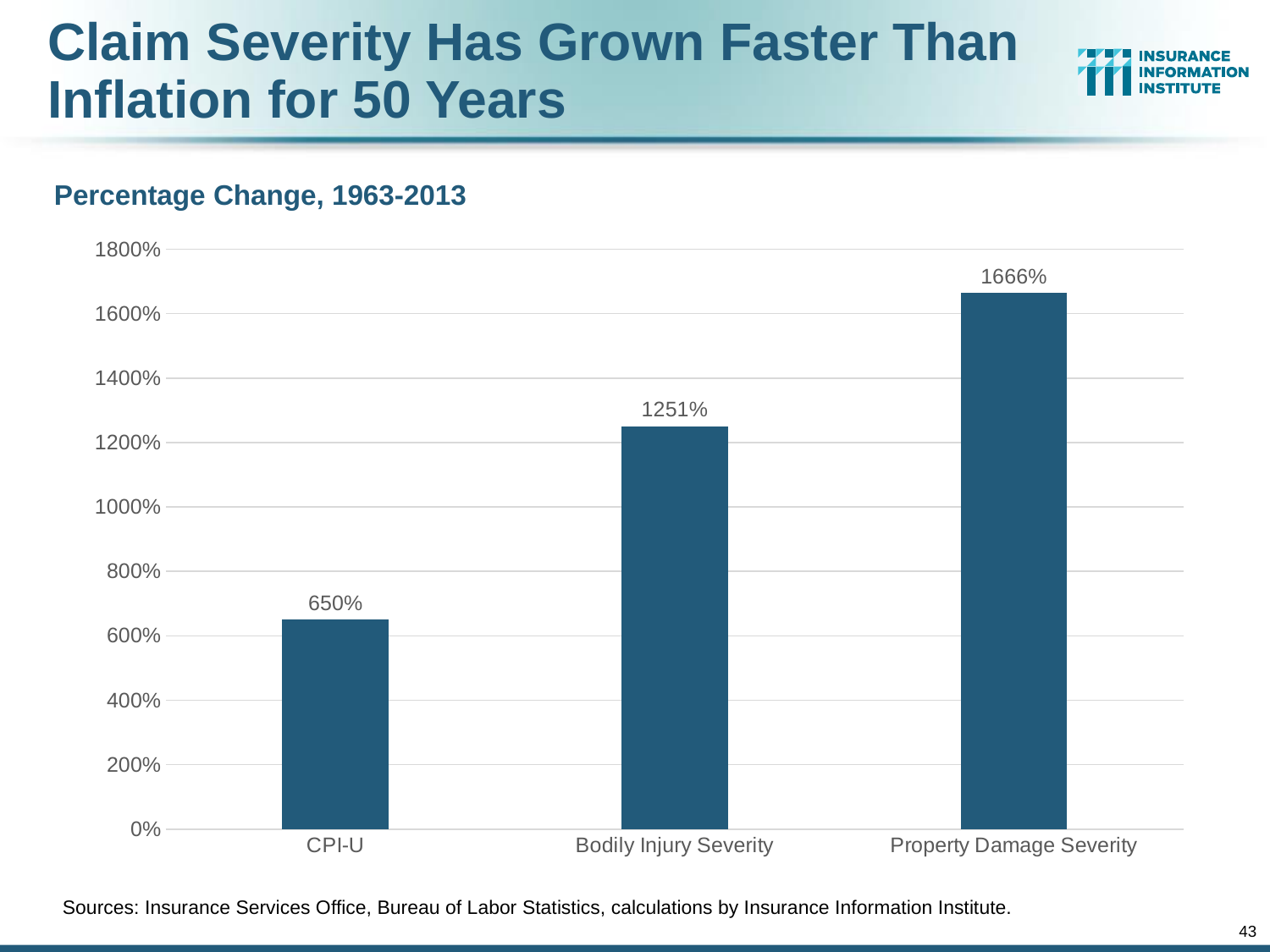
What is the percentage change for Property Damage Severity? 1666% What is the difference in percentage points between Property Damage Severity and Bodily Injury Severity? 415 What period does the chart's subtitle say the percentage change covers? 1963-2013 Is the value for Bodily Injury Severity greater or less than 1400%? less What is the percentage change for Bodily Injury Severity? 1251% What kind of chart is shown on the slide? Bar chart Which category has the highest percentage change? Property Damage Severity Which is larger, the value for Bodily Injury Severity or the value for CPI-U? Bodily Injury Severity What is the percentage change for CPI-U? 650% What is the difference in percentage points between Bodily Injury Severity and CPI-U? 601 Which category has the lowest percentage change? CPI-U How many categories are shown on the chart? 3